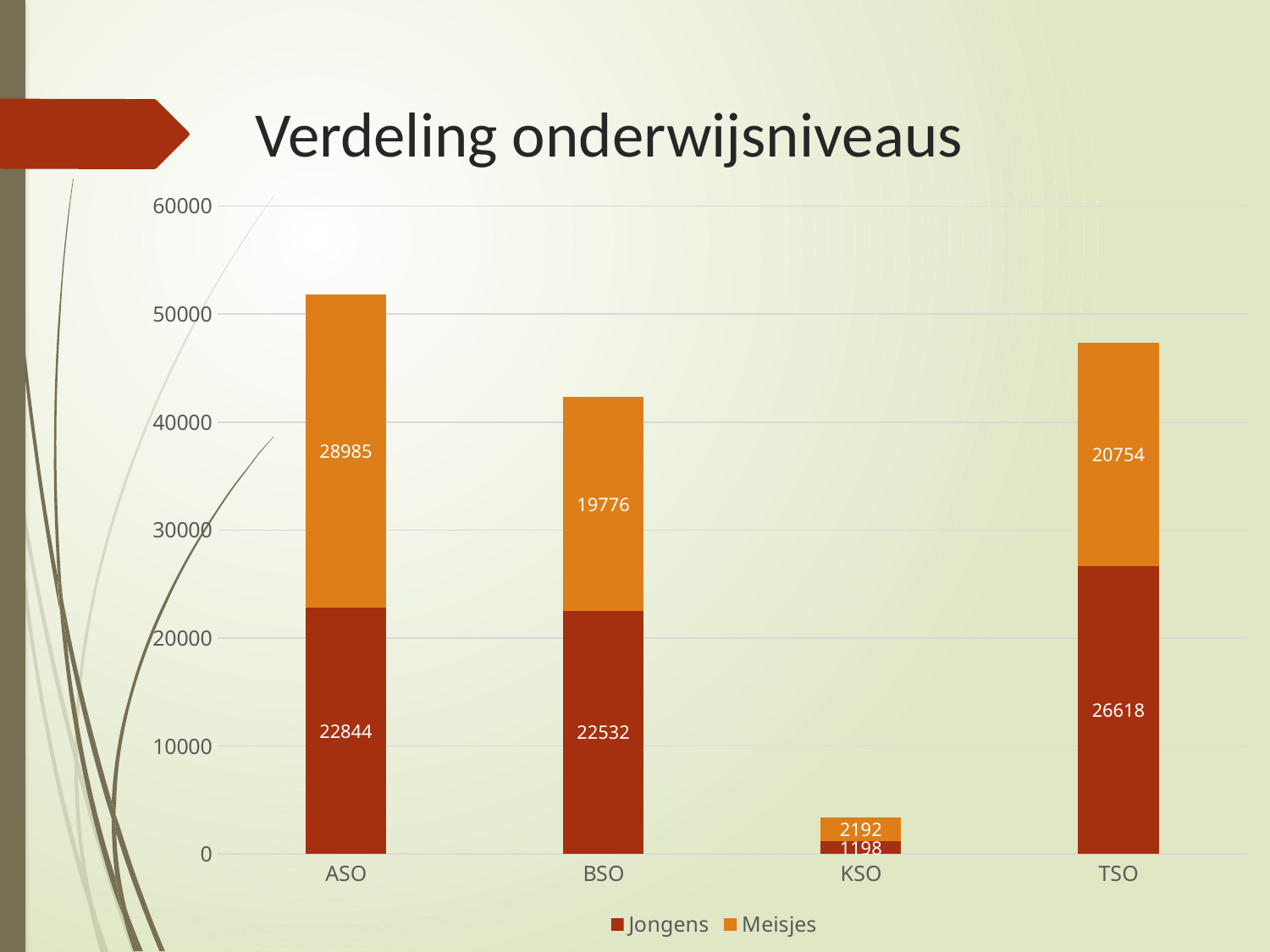
What type of chart is shown on the slide? Stacked bar chart Is the total of the stacked bar for ASO greater or less than 50000? greater Which category has the highest value for Jongens? TSO How many series does the legend list? 2 What is the value for Meisjes in the KSO category? 2192 What is the difference between the Meisjes and Jongens values in the ASO category? 6141 Which category has the lowest value for Meisjes? KSO What is the value for Meisjes in the TSO category? 20754 What is the value for Jongens in the ASO category? 22844 What is the total of the stacked bar for BSO? 42308 Which is larger: the Jongens value for BSO or the Jongens value for TSO? TSO How many categories are shown on the x axis? 4